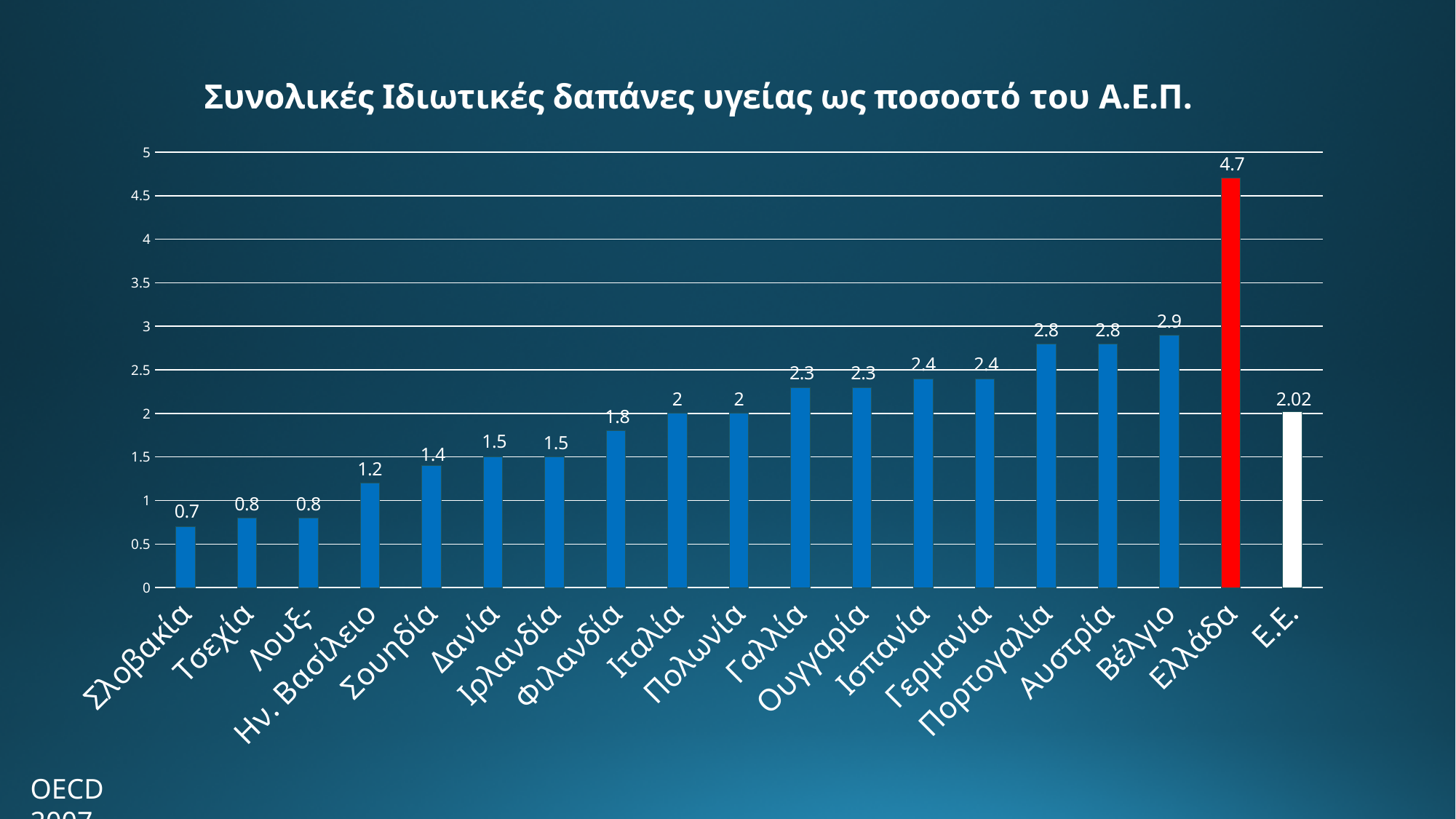
What is the value shown for Ελλάδα? 4.7 Is the value for Πορτογαλία greater or less than 2.5? greater Which category has the lowest value? Σλοβακία What is the difference between the values for Ελλάδα and Βέλγιο? 1.8 What is the title of the chart? Συνολικές Ιδιωτικές δαπάνες υγείας ως ποσοστό του Α.Ε.Π. What is the value shown for Βέλγιο? 2.9 How many categories are shown on the x axis? 19 What kind of chart is shown on the slide? bar chart Which is larger, the value for Φιλανδία or the value for Σουηδία? Φιλανδία What is the value shown for Ε.Ε.? 2.02 What is the value shown for Ην. Βασίλειο? 1.2 Which category has the highest value? Ελλάδα